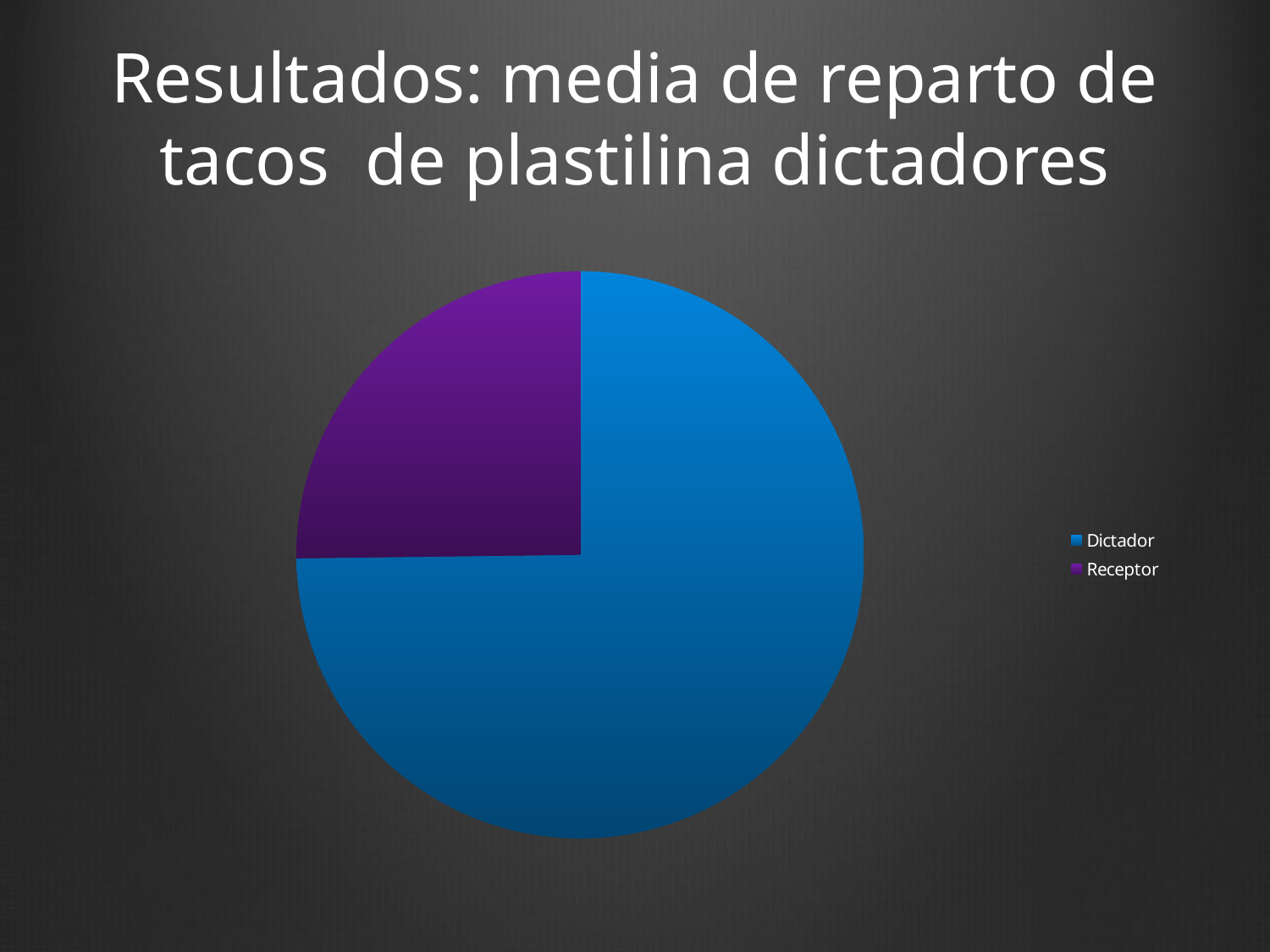
What kind of chart is shown on the slide? Pie chart Which slice of the pie chart is the largest? Dictador Which slice is larger in the pie chart, Dictador or Receptor? Dictador How many entries does the legend of the pie chart list? 2 How many slices does the pie chart have? 2 What colour is the Receptor slice in the pie chart? Purple What colour is the Dictador slice in the pie chart? Blue Which slice of the pie chart is the smallest? Receptor